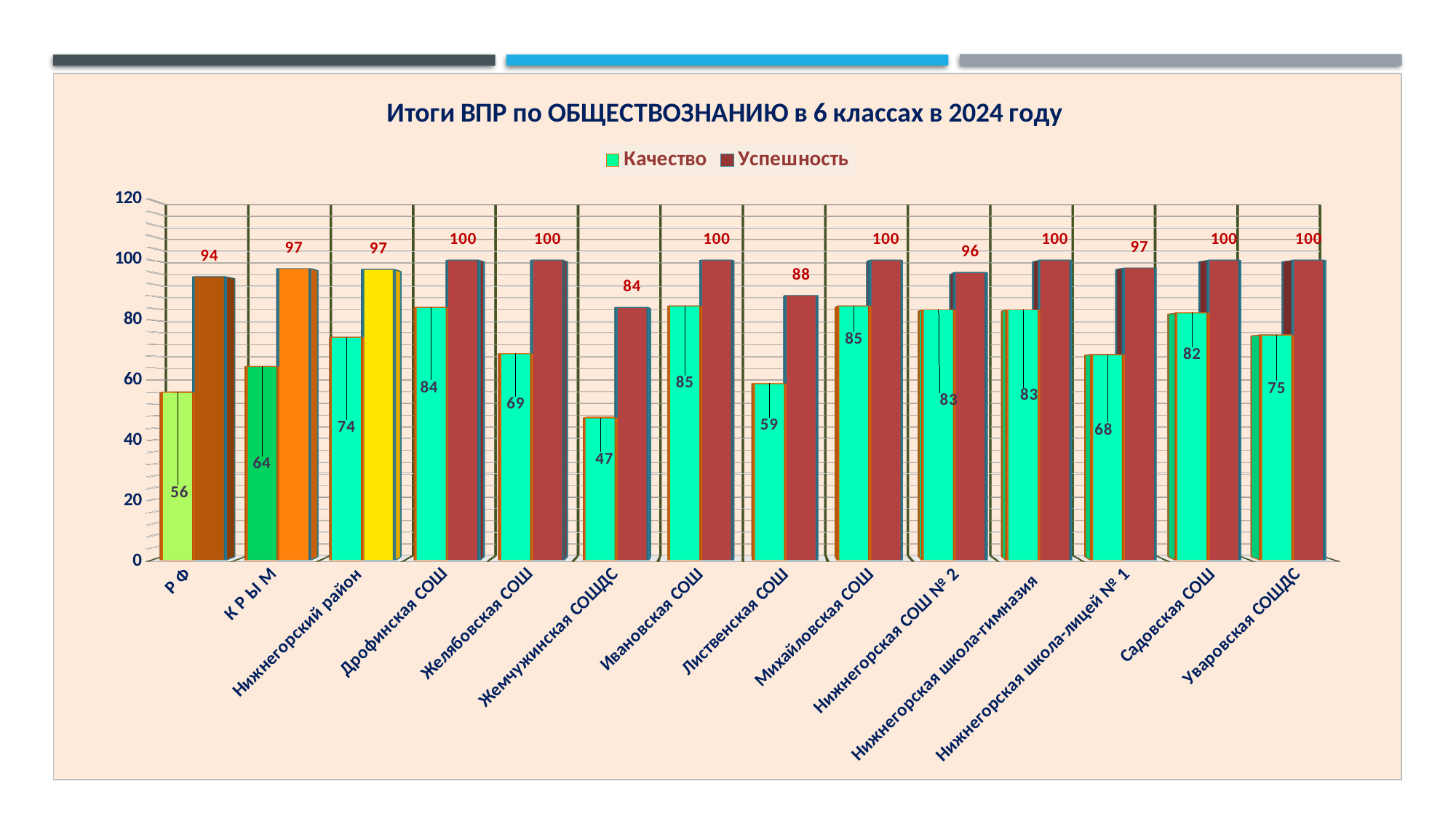
Which category has the lowest Успешность value? Жемчужинская СОШДС How many series does the legend list? 2 Which is larger, the Качество value for Садовская СОШ or for Уваровская СОШДС? Садовская СОШ What is the title of the chart? Итоги ВПР по ОБЩЕСТВОЗНАНИЮ в 6 классах в 2024 году What is the difference between Успешность and Качество for Лиственская СОШ? 29 What is the Качество value for Жемчужинская СОШДС? 47 Which category has the lowest Качество value? Жемчужинская СОШДС What is the Успешность value for Р Ф? 94 How many categories are shown on the x axis? 14 What is the Качество value for Нижнегорский район? 74 What is the Успешность value for Лиственская СОШ? 88 What kind of chart is shown on the slide? Bar chart